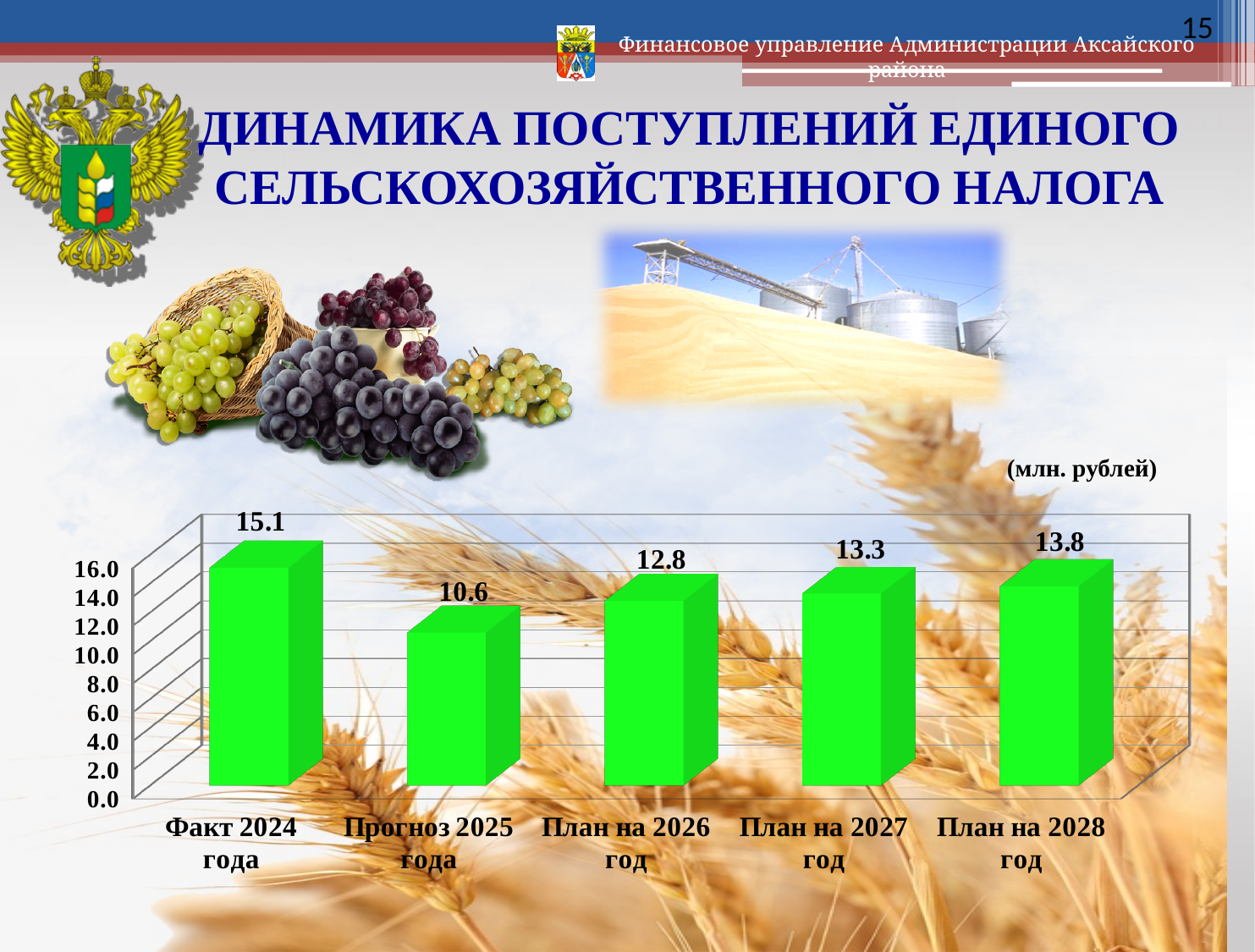
What kind of chart is shown on the slide? bar chart Which category has the lowest value? Прогноз 2025 года What is the value for План на 2028 год? 13.8 Which is larger, the value for План на 2027 год or the value for План на 2026 год? План на 2027 год How many categories are shown on the chart? 5 What is the difference between the values for План на 2028 год and План на 2027 год? 0.5 What is the value for Факт 2024 года? 15.1 What is the value for Прогноз 2025 года? 10.6 What is the value for План на 2026 год? 12.8 What unit of measurement is indicated for the chart values? млн. рублей Which category has the highest value? Факт 2024 года What is the difference between the values for Факт 2024 года and Прогноз 2025 года? 4.5